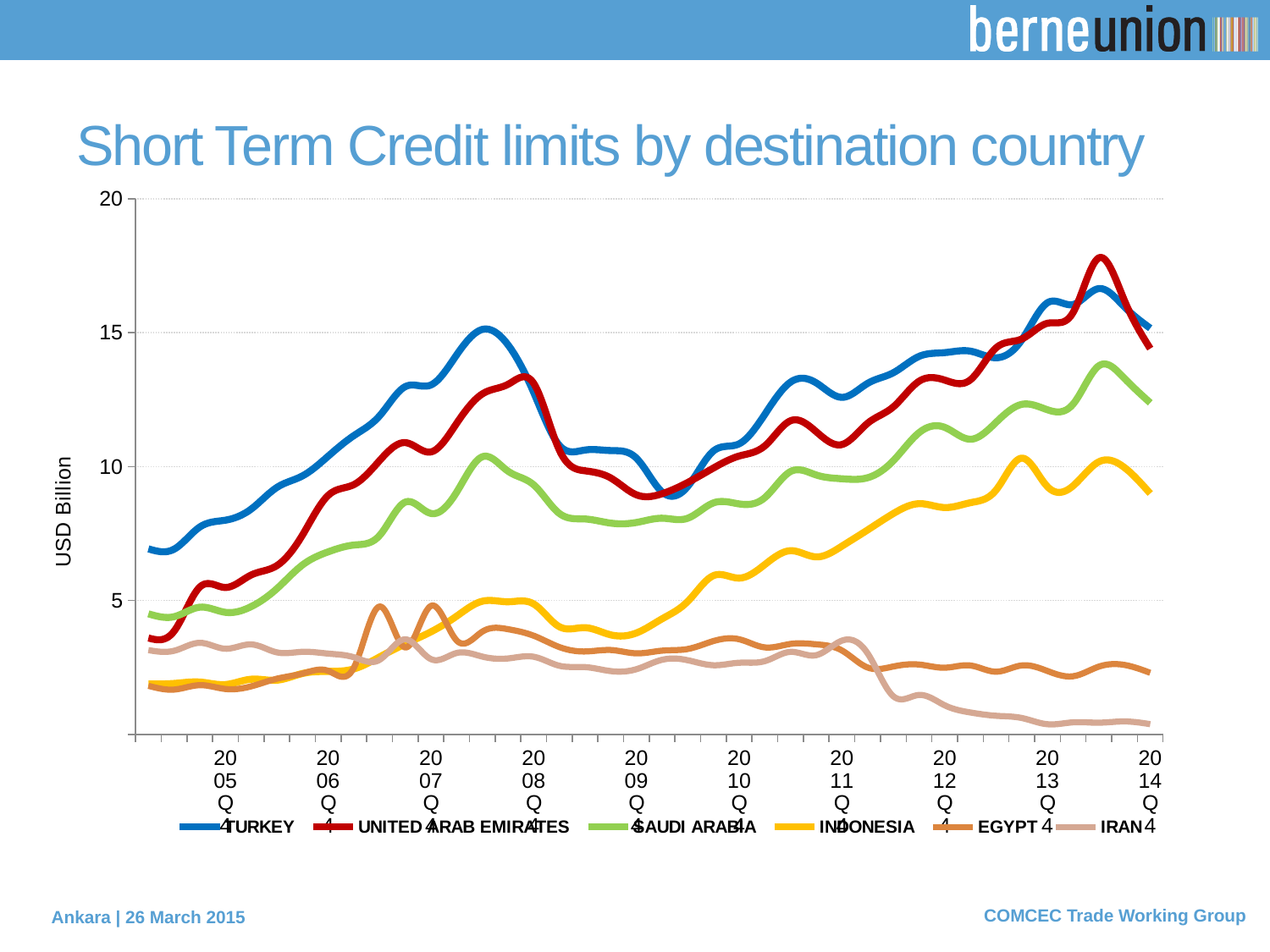
What is the label on the vertical axis? USD Billion Is the value for Turkey at 2014 Q4 greater or less than 10? greater Is the value for Egypt at 2014 Q4 greater or less than 5? less Which country's line reaches the highest point anywhere on the chart? United Arab Emirates What kind of chart is shown on the slide? line chart Which country has the lowest value at 2014 Q4? Iran What is the title of the chart? Short Term Credit limits by destination country At 2014 Q4, which is larger: Turkey or Saudi Arabia? Turkey Is the value for Iran at 2014 Q4 greater or less than 5? less At 2014 Q4, which is larger: Saudi Arabia or Indonesia? Saudi Arabia How many series does the legend list? 6 Does the Indonesia line generally rise or fall from 2005 Q4 to 2014 Q4? rise